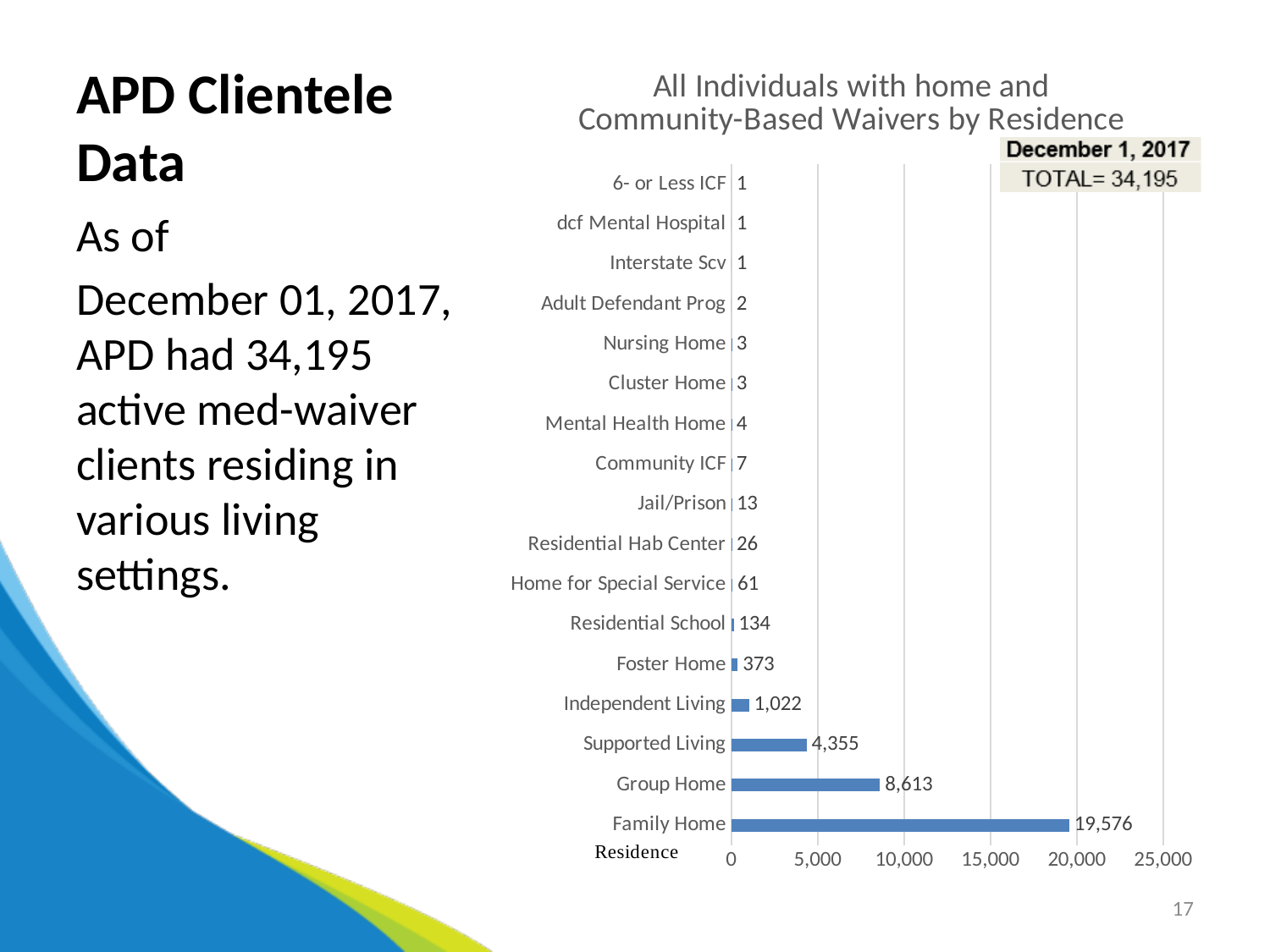
What is the difference between the values for Family Home and Group Home? 10,963 What is the value for Residential Hab Center? 26 What is the value for Group Home? 8,613 What is the difference between the values for Group Home and Supported Living? 4,258 What is the value for Foster Home? 373 What is the value for Supported Living? 4,355 How many residence categories are shown in the chart? 17 Is the value for Family Home greater or less than 15,000? greater Which is larger, the value for Independent Living or the value for Foster Home? Independent Living What type of chart is shown on the slide? bar chart What is the value for Family Home? 19,576 Which residence category has the highest value? Family Home